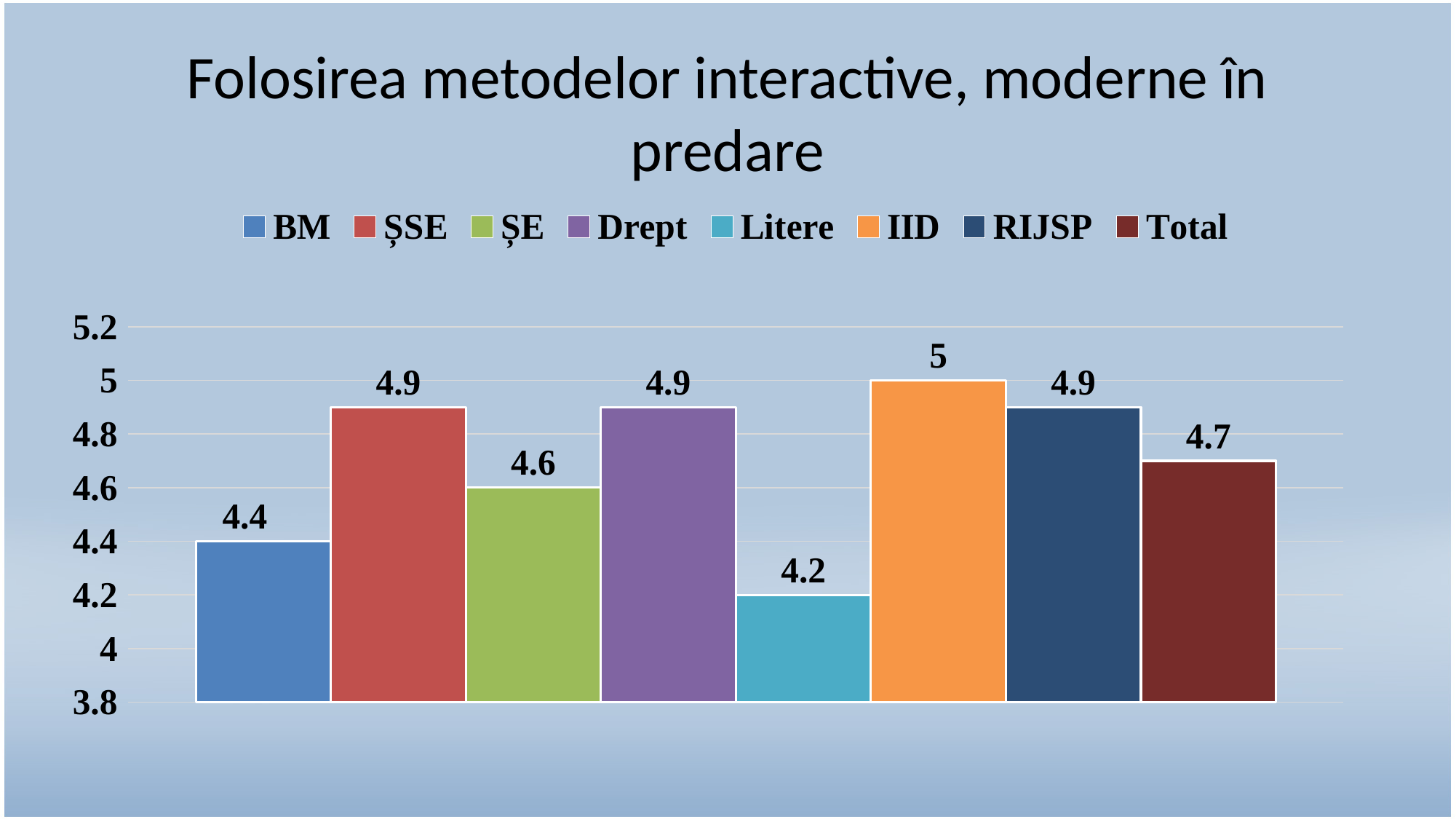
What is the title of the chart? Folosirea metodelor interactive, moderne în predare What is the difference between the values for IID and Litere? 0.8 What kind of chart is shown on the slide? bar chart How many series does the legend list? 8 What is the value for Litere? 4.2 Which series has the lowest value? Litere What is the value for Total? 4.7 Which is larger, the value for ȘE or the value for Total? Total What is the difference between the values for ȘSE and BM? 0.5 Which series has the highest value? IID What is the value for ȘE? 4.6 What is the value for BM? 4.4